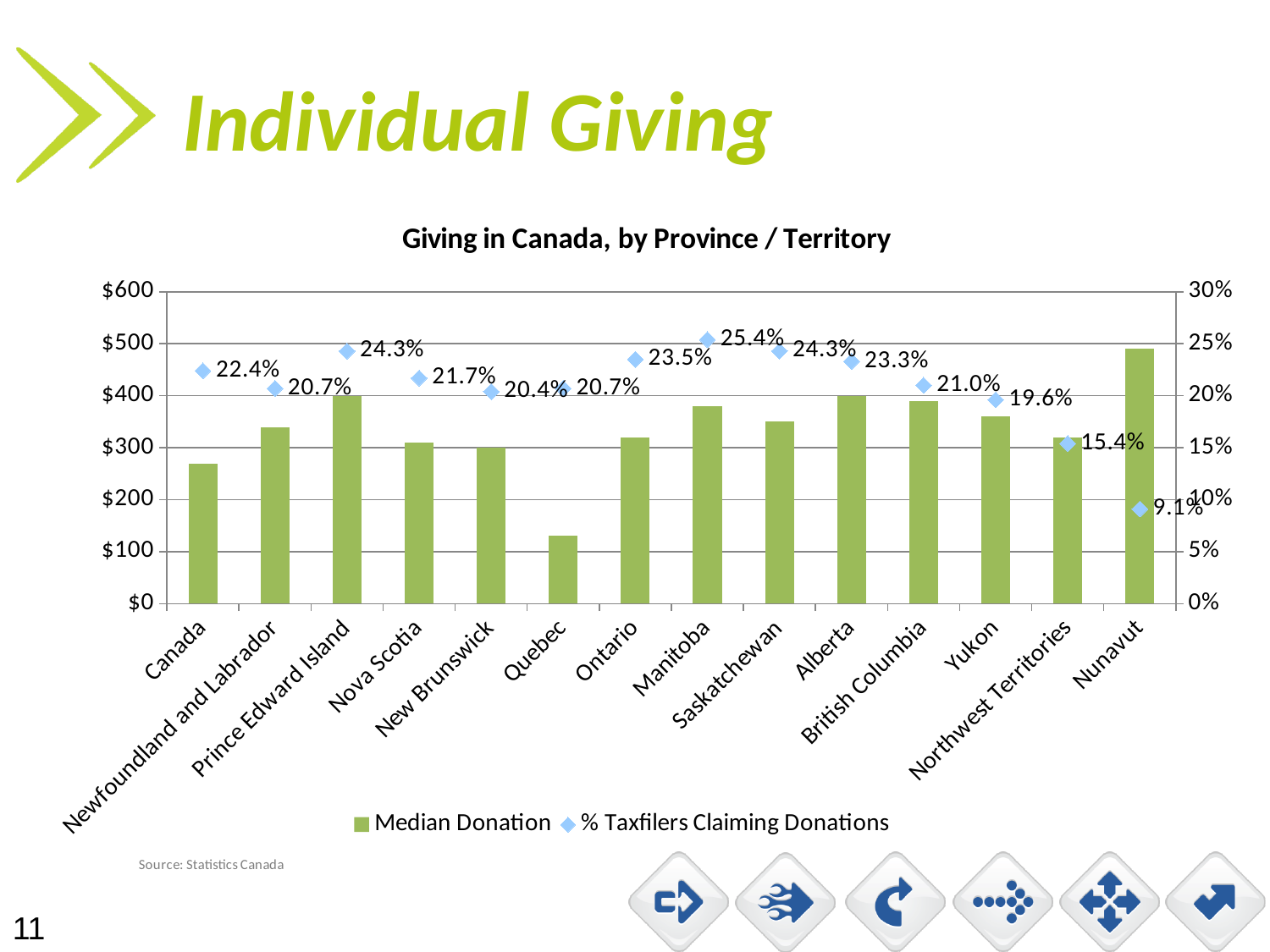
What is the title of the chart? Giving in Canada, by Province / Territory What percentage of taxfilers claimed donations in Canada overall? 22.4% Which province or territory has the highest % Taxfilers Claiming Donations? Manitoba Which has a higher % Taxfilers Claiming Donations, Ontario or Yukon? Ontario What percentage of taxfilers claimed donations in Manitoba? 25.4% Is the Median Donation for Quebec greater or less than $200? less How many series does the legend list? 2 What is the difference in % Taxfilers Claiming Donations between Manitoba and Nunavut? 16.3% What is the % Taxfilers Claiming Donations value for Nunavut? 9.1% How many provinces/territories (including Canada) are shown on the x axis? 14 Which province or territory has the lowest % Taxfilers Claiming Donations? Nunavut Is the Median Donation for Nunavut greater or less than $400? greater